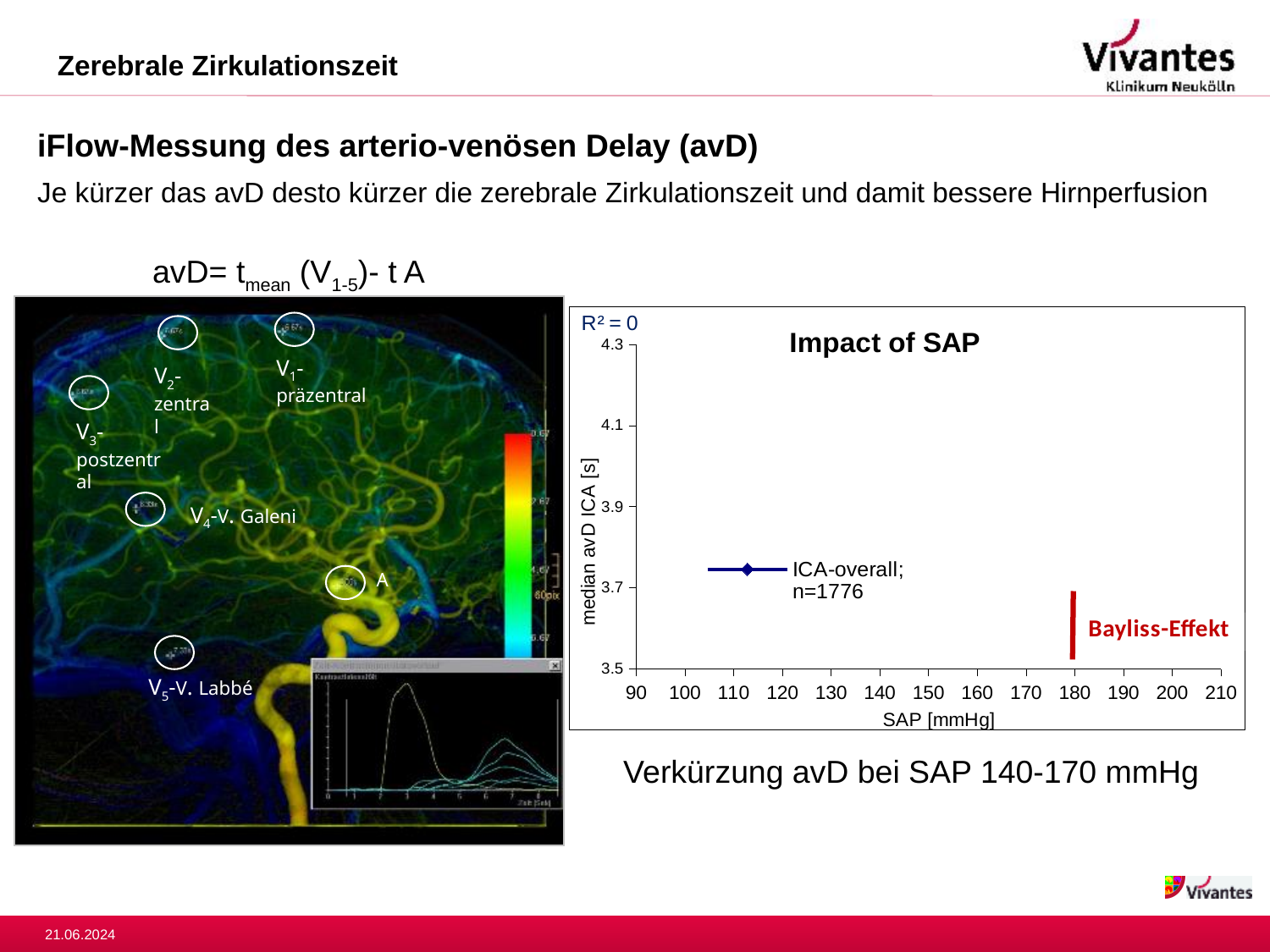
What is the title of the chart on the right side of the slide? Impact of SAP How many series does the legend of the 'Impact of SAP' chart list? 1 In the 'Impact of SAP' chart, what is the name of the series shown in the legend? ICA-overall; n=1776 In the 'Impact of SAP' chart, what is the label of the x axis? SAP [mmHg] In the 'Impact of SAP' chart, what R² value is printed above the plot? R² = 0 In the 'Impact of SAP' chart, at which SAP value is the red vertical line labelled 'Bayliss-Effekt' drawn? 180